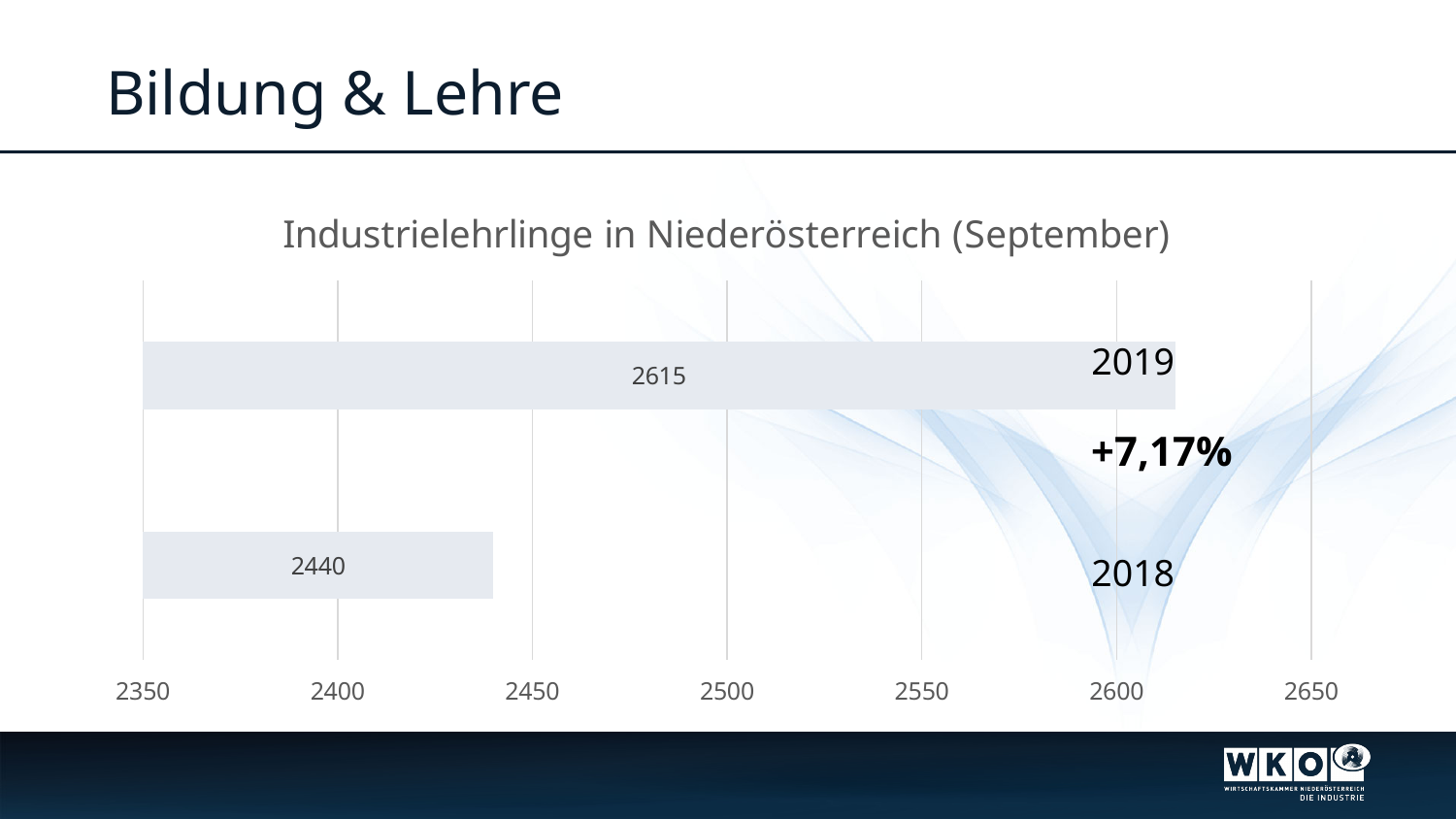
Is the value for 2019 greater or less than 2600? greater What is the value for 2018? 2440 What is the difference between the 2019 and 2018 values? 175 Is the value for 2018 greater or less than 2450? less Which year has the lower value? 2018 Is the value for 2019 larger than the value for 2018? Yes What percentage change is shown between 2018 and 2019? +7,17% Which year has the higher value? 2019 What is the title of the chart? Industrielehrlinge in Niederösterreich (September) What kind of chart is shown? Bar chart What is the value for 2019? 2615 How many bars are shown in the chart? 2